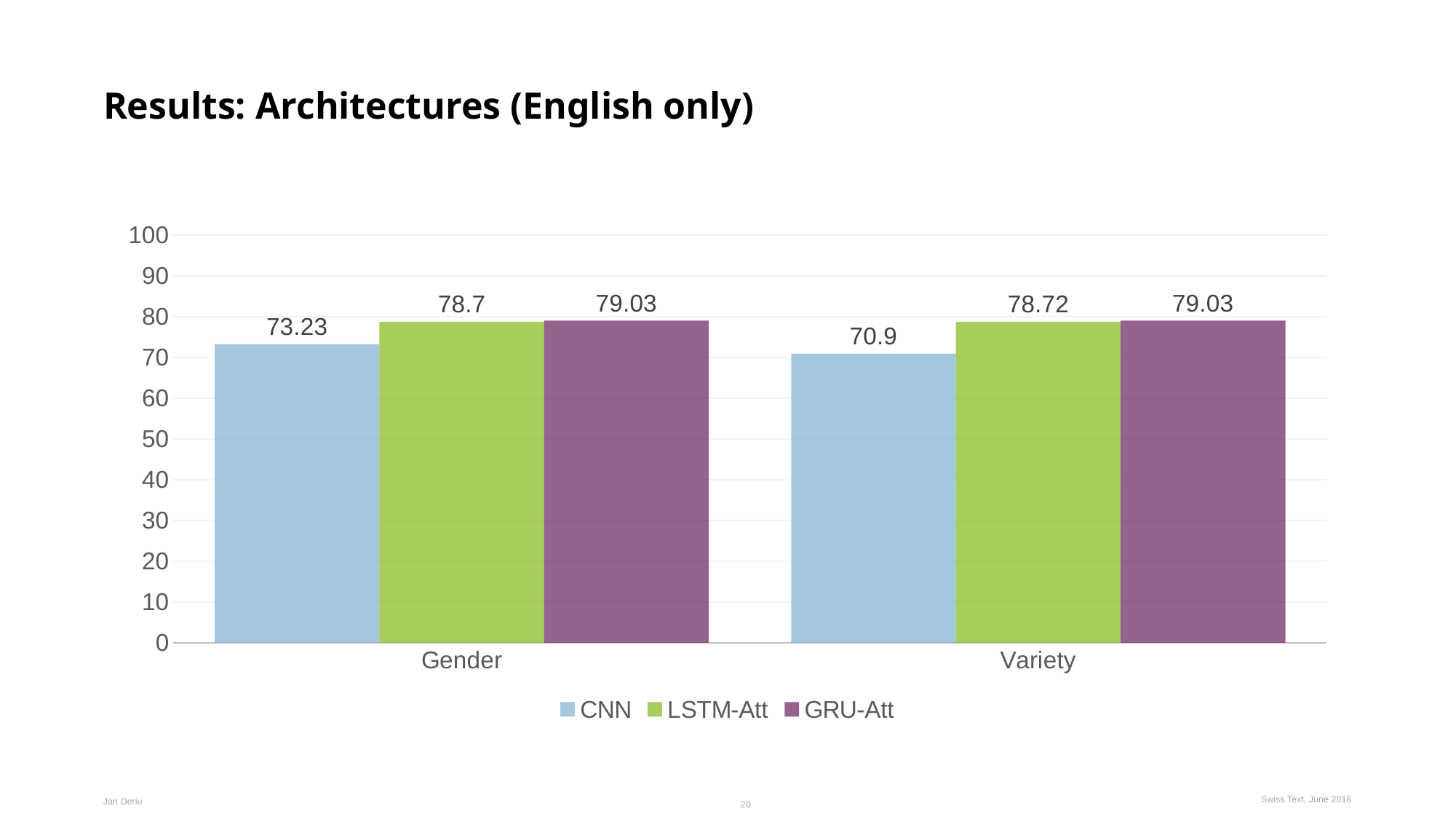
What type of chart is shown on the slide? Bar chart Which architecture has the lowest value in the Gender category? CNN What is the value for LSTM-Att in the Variety category? 78.72 What is the difference between the GRU-Att and CNN values in the Gender category? 5.8 Which architecture has the lowest value in the Variety category? CNN Which is larger: the CNN value for Gender or the CNN value for Variety? Gender What is the value for CNN in the Gender category? 73.23 What is the difference between the CNN values for Gender and Variety? 2.33 What is the value for CNN in the Variety category? 70.9 What is the value for GRU-Att in the Gender category? 79.03 How many series does the legend list? 3 How many categories are shown on the x axis? 2